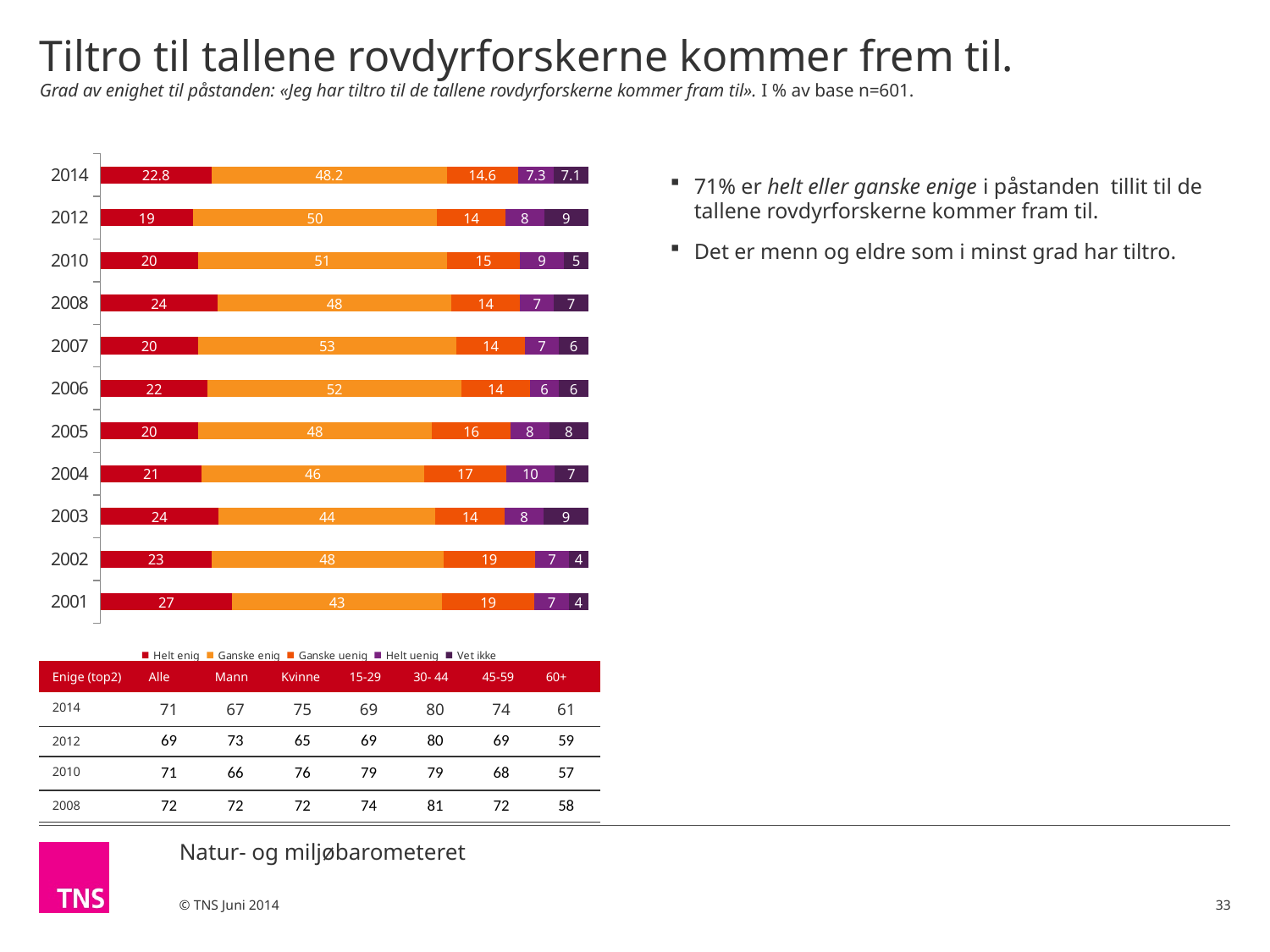
What is the total of the stacked bar for 2010? 100 In which year is the Helt enig value highest? 2001 How many years (categories) are plotted in the chart? 11 How many series does the chart legend list? 5 What is the value for Vet ikke in 2012? 9 Which year has the larger Helt enig value, 2008 or 2007? 2008 What is the value for Helt enig in 2014? 22.8 What kind of chart is shown on the slide? Stacked bar chart What is the difference between the Helt enig values for 2014 and 2012? 3.8 What is the value for Ganske enig in 2007? 53 Which legend entry is shown in red (the first segment of each bar)? Helt enig In which year is the Ganske enig value lowest? 2001